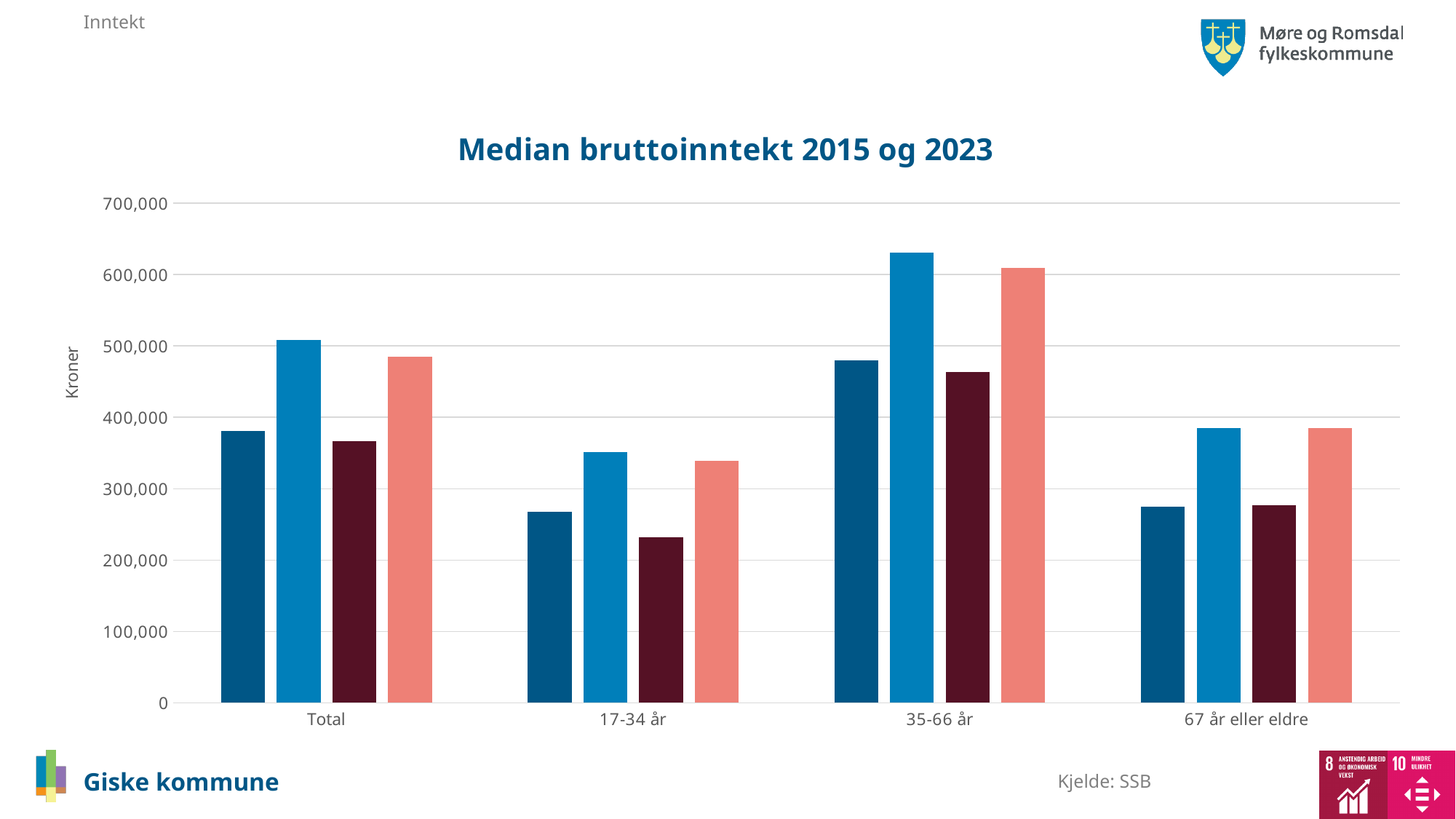
Which is larger: the dark blue bar for Total or the dark blue bar for 67 år eller eldre? Total Is the dark red bar for 35-66 år greater or less than 500,000? less What kind of chart is shown on the slide? bar chart Is the dark blue bar for 17-34 år greater or less than 300,000? less Which category has the lowest light blue bar on the chart? 17-34 år What is the label on the vertical axis of the chart? Kroner How many bars are plotted for each category on the chart? 4 Is the light blue bar for 35-66 år greater or less than 600,000? greater Which category has the tallest bars on the chart? 35-66 år How many categories are shown on the x axis of the chart? 4 What is the title of the chart? Median bruttoinntekt 2015 og 2023